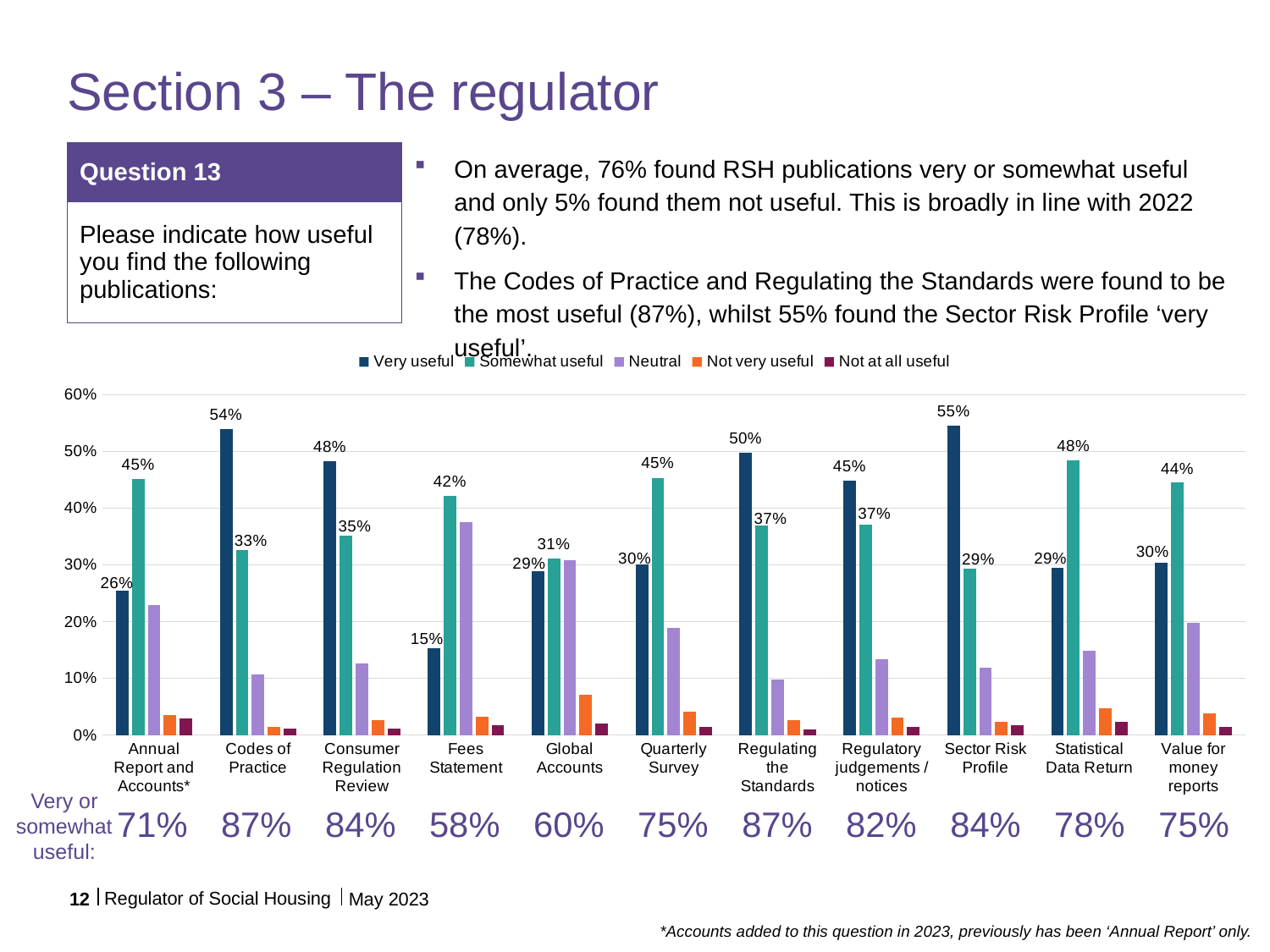
Which publication has the highest 'Somewhat useful' percentage? Statistical Data Return How many publications are shown on the x axis of the chart? 11 Which publication has the lowest 'Very useful' percentage? Fees Statement What type of chart is shown on the slide? Bar chart What is the 'Very useful' value for the Fees Statement? 15% Which publication has the highest 'Very useful' percentage? Sector Risk Profile How many series does the chart legend list? 5 Which is larger for the Quarterly Survey: the 'Very useful' value or the 'Somewhat useful' value? Somewhat useful What percentage of respondents found the Sector Risk Profile 'Very useful'? 55% What is the 'Somewhat useful' value for the Statistical Data Return? 48% Is the 'Neutral' value for the Fees Statement greater or less than 30%? greater What is the difference between the 'Very useful' and 'Somewhat useful' values for Codes of Practice? 21 percentage points